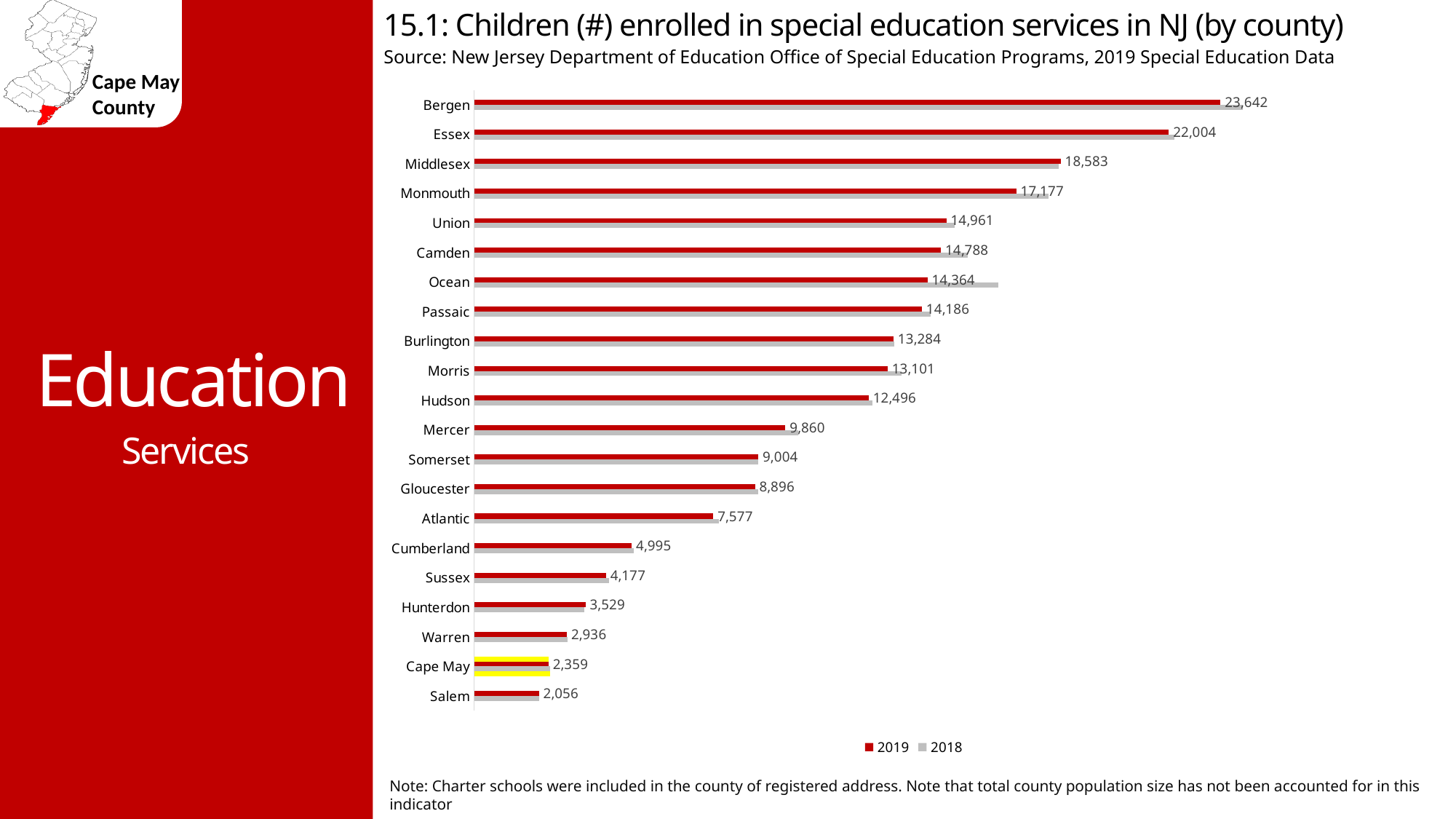
Which county has a larger 2019 value, Mercer or Somerset? Mercer What is the difference between the 2019 values for Cape May and Salem? 303 For Ocean, which bar is longer, 2018 or 2019? 2018 How many counties are shown on the chart? 21 What kind of chart is shown on the slide? Bar chart How many children were enrolled in special education services in Bergen in 2019? 23,642 What is the 2019 value for Cape May? 2,359 Which county has the highest 2019 value? Bergen What is the difference between the 2019 values for Bergen and Essex? 1,638 How many series does the legend list? 2 Which county has the lowest 2019 value? Salem What is the 2019 value shown for Atlantic? 7,577